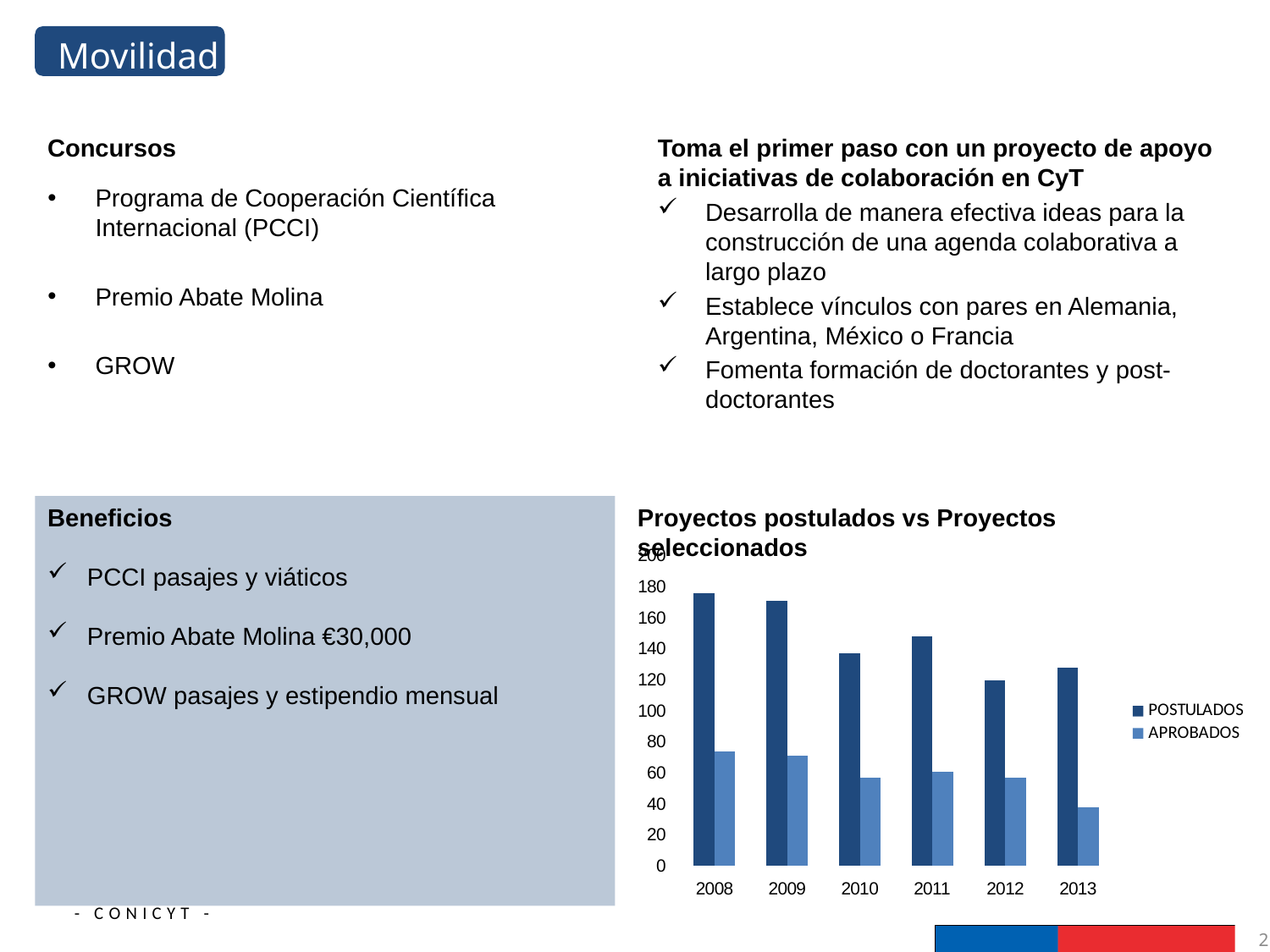
Which is larger, the POSTULADOS value for 2010 or the POSTULADOS value for 2011? 2011 Do the POSTULADOS values generally rise or fall from 2008 to 2013? fall Is the POSTULADOS value for 2008 greater or less than 160? greater How many series does the legend of the chart list? 2 Is the POSTULADOS value for 2012 greater or less than 100? greater Which year has the lowest POSTULADOS value? 2012 Which year has the highest POSTULADOS value? 2008 How many years are shown on the x axis of the chart? 6 What kind of chart is shown on the slide? bar chart What are the two series named in the chart legend? POSTULADOS and APROBADOS Which year has the lowest APROBADOS value? 2013